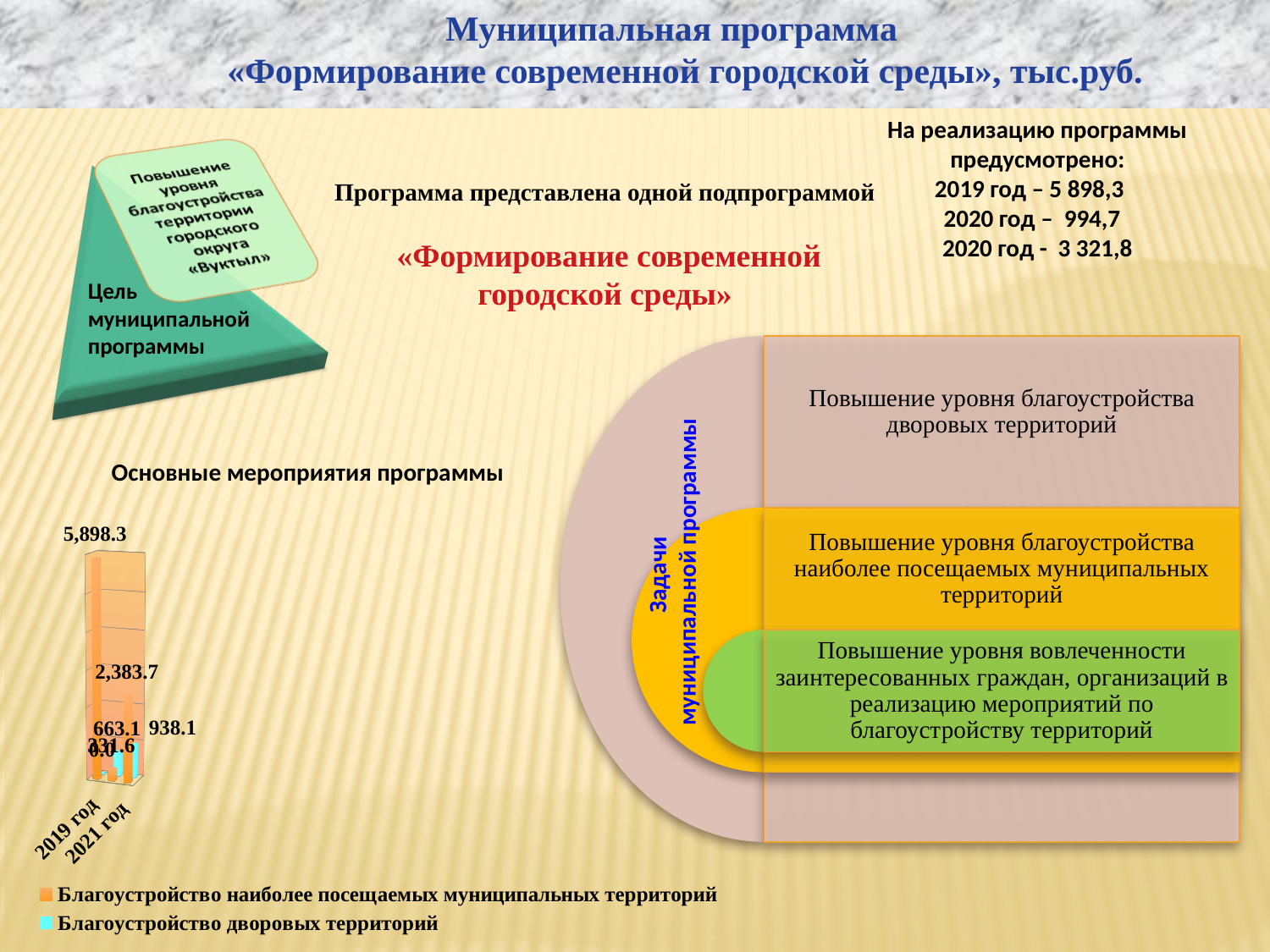
In the chart «Основные мероприятия программы», what is the value of the tallest bar, for 2019 год? 5,898.3 In the chart «Основные мероприятия программы», which is larger: the bar labelled 5,898.3 or the bar labelled 2,383.7? 5,898.3 Which legend entry of the chart «Основные мероприятия программы» is shown in light blue? Благоустройство дворовых территорий What kind of chart is shown under the heading «Основные мероприятия программы»? bar chart What is the lowest data label printed on the chart «Основные мероприятия программы»? 0.0 In the chart «Основные мероприятия программы», which year has the highest value for «Благоустройство наиболее посещаемых муниципальных территорий»? 2019 год Which legend entry of the chart «Основные мероприятия программы» is shown in orange? Благоустройство наиболее посещаемых муниципальных территорий How many series does the legend of the chart «Основные мероприятия программы» list? 2 What is the highest data label printed on the chart «Основные мероприятия программы»? 5,898.3